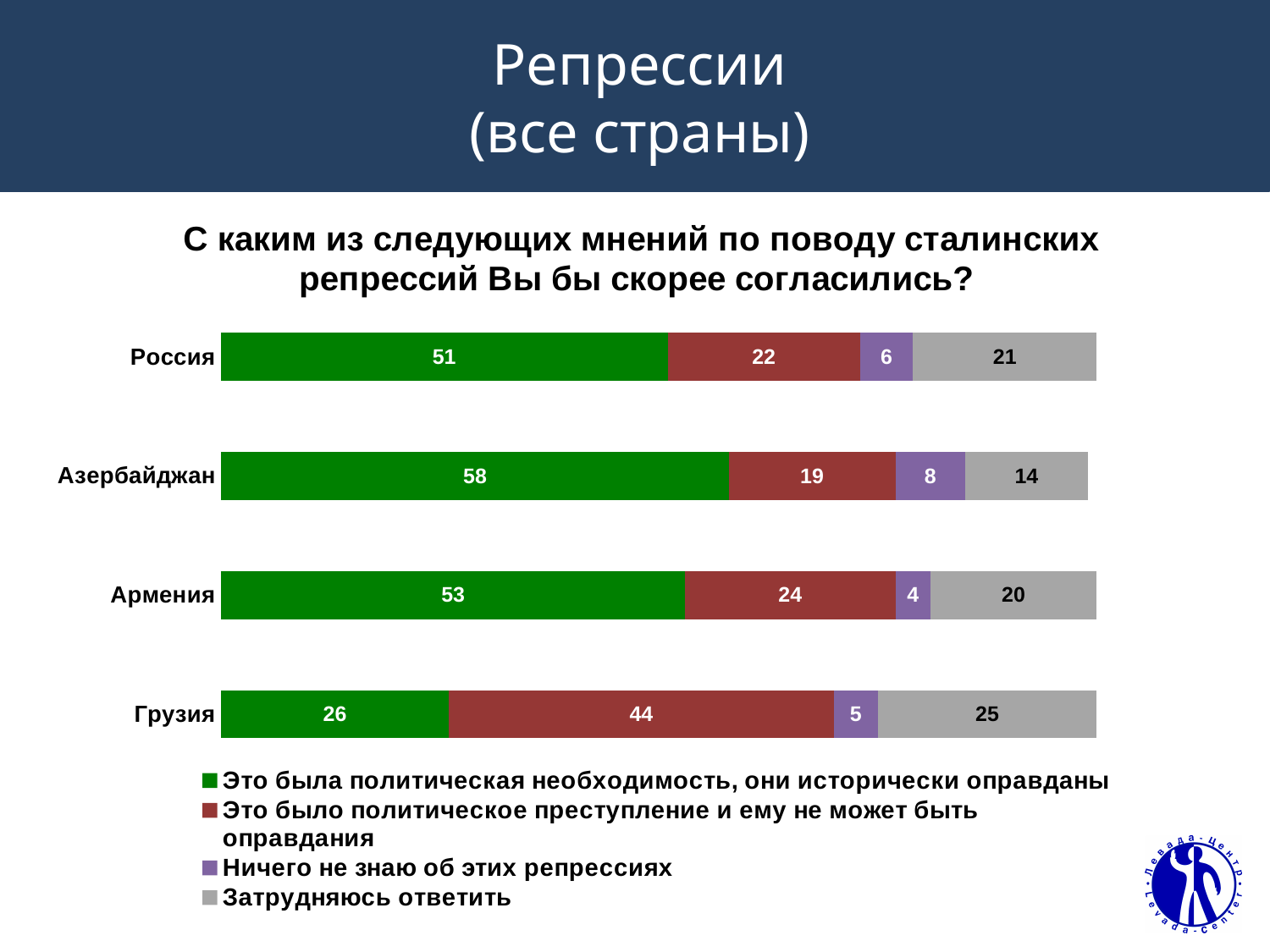
What is the total of the stacked bar for Азербайджан? 99 What value is shown for Азербайджан in the series "Ничего не знаю об этих репрессиях"? 8 What value is shown for Грузия in the series "Это было политическое преступление и ему не может быть оправдания"? 44 What kind of chart is shown on the slide? Stacked bar chart What value is shown for Армения in the series "Затрудняюсь ответить"? 20 Which country has the highest value for "Это была политическая необходимость, они исторически оправданы"? Азербайджан How many countries are shown in the chart? 4 What is the difference between the "Это было политическое преступление и ему не может быть оправдания" values for Грузия and Россия? 22 How many series does the legend list? 4 What value is shown for Россия in the series "Это была политическая необходимость, они исторически оправданы"? 51 Which is larger: the "Затрудняюсь ответить" value for Россия or for Азербайджан? Россия Which country has the lowest value for "Ничего не знаю об этих репрессиях"? Армения